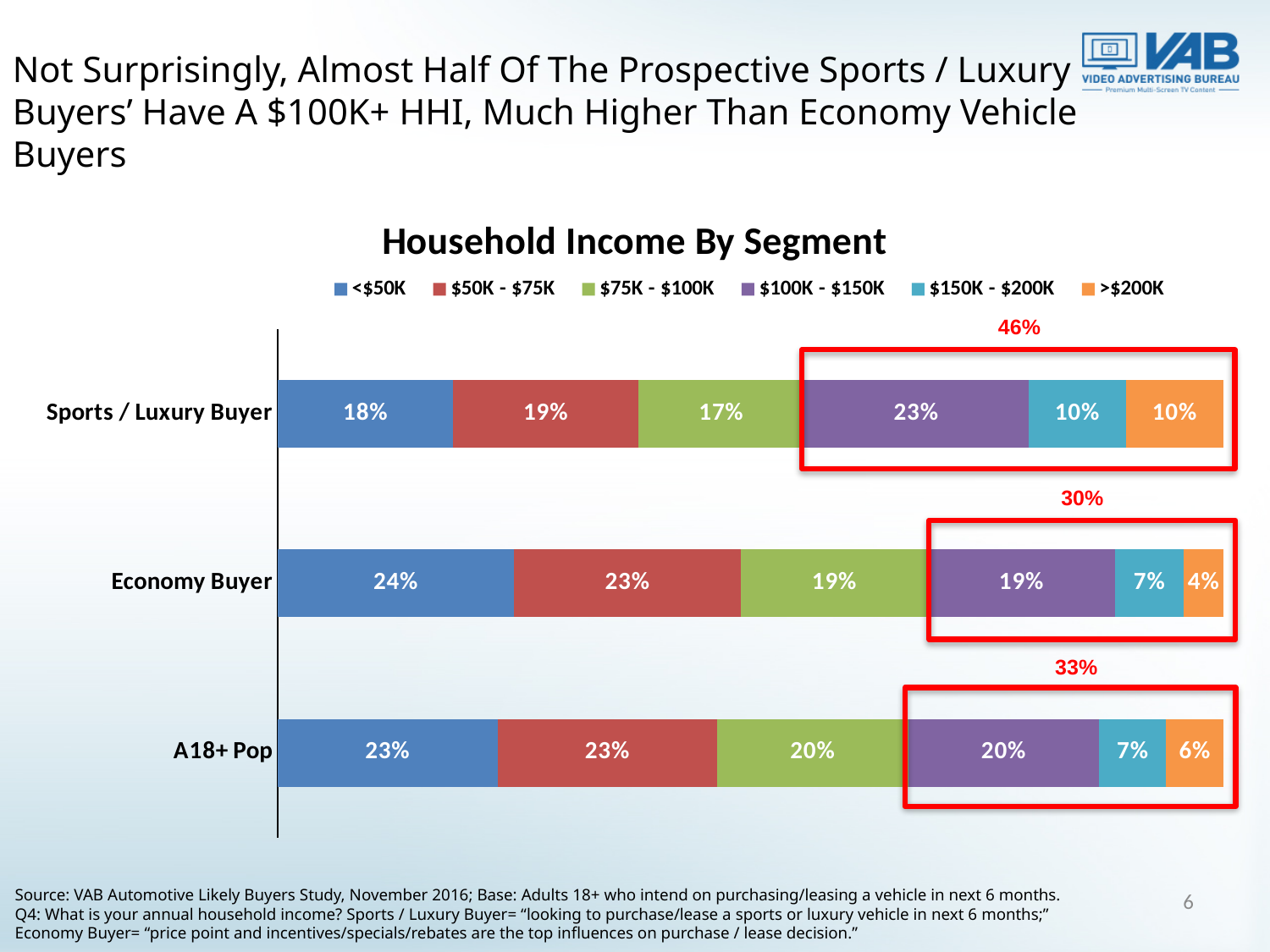
How many series does the legend list? 6 How many segments (categories) are plotted on the chart? 3 Which is larger: the $150K - $200K value for Sports / Luxury Buyer or for A18+ Pop? Sports / Luxury Buyer What type of chart is shown on the slide? Stacked bar chart What is the difference between the $100K - $150K values for Sports / Luxury Buyer and Economy Buyer? 4% What is the title of the chart? Household Income By Segment What is the $100K - $150K value for Economy Buyer? 19% Which segment has the highest <$50K value? Economy Buyer What is the <$50K value for Sports / Luxury Buyer? 18% What is the >$200K value for A18+ Pop? 6% What red percentage is annotated above the highlighted $100K+ portion of the Sports / Luxury Buyer bar? 46% Which segment has the lowest >$200K value? Economy Buyer